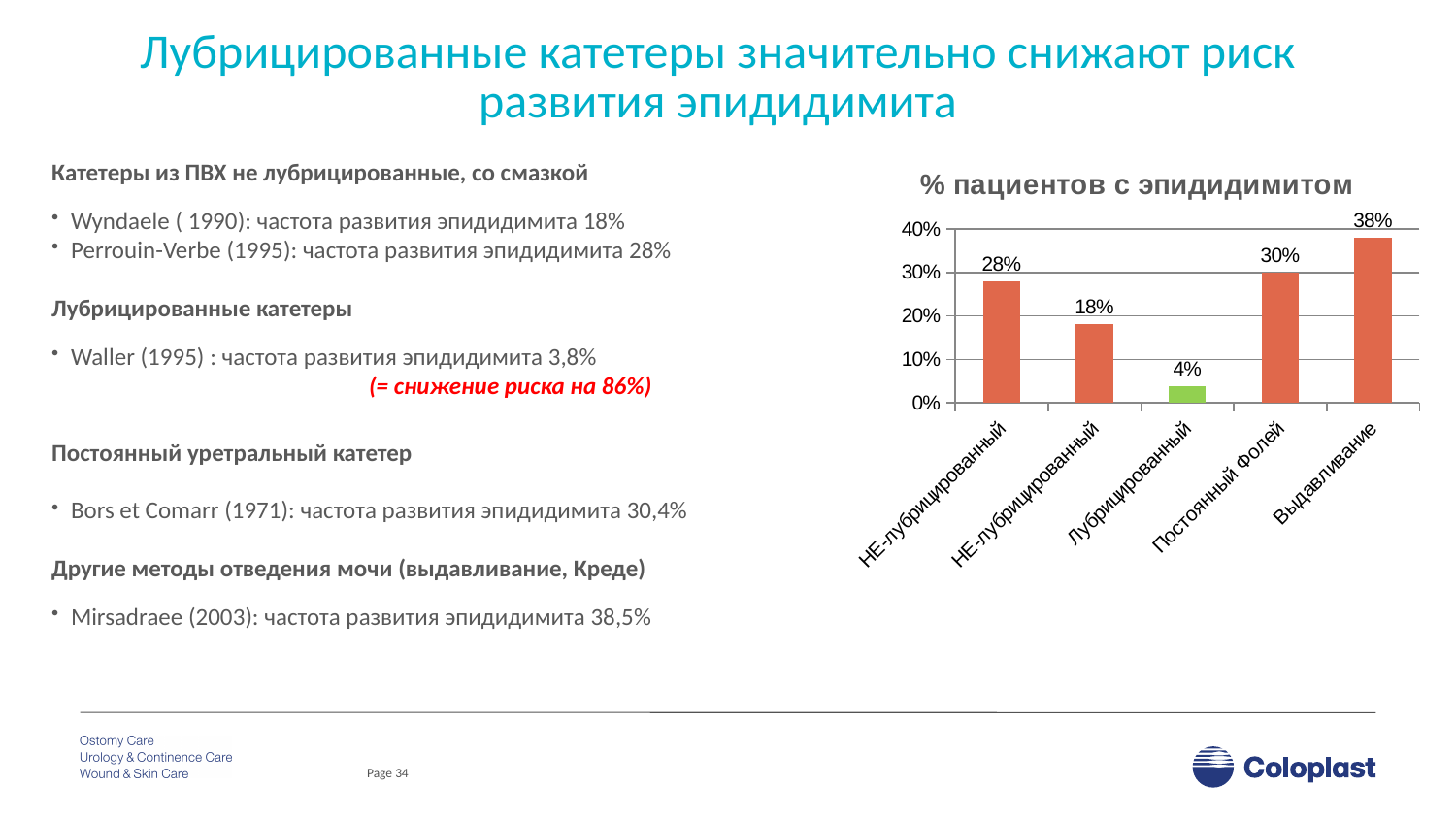
What is the value for Выдавливание in the chart? 38% What is the difference between the values for Выдавливание and Лубрицированный? 34% What is the title of the chart on the slide? % пациентов с эпидидимитом What is the value of the first (leftmost) НЕ-лубрицированный bar in the chart? 28% Which category has the lowest value in the chart? Лубрицированный What is the value for Постоянный Фолей in the chart? 30% How many bars does the chart show? 5 What is the value for Лубрицированный in the chart? 4% Which is larger, the value for Постоянный Фолей or the value for Лубрицированный? Постоянный Фолей Which category has the highest value in the chart? Выдавливание What type of chart is shown on the slide? bar chart Which bar in the chart is coloured green rather than orange? Лубрицированный